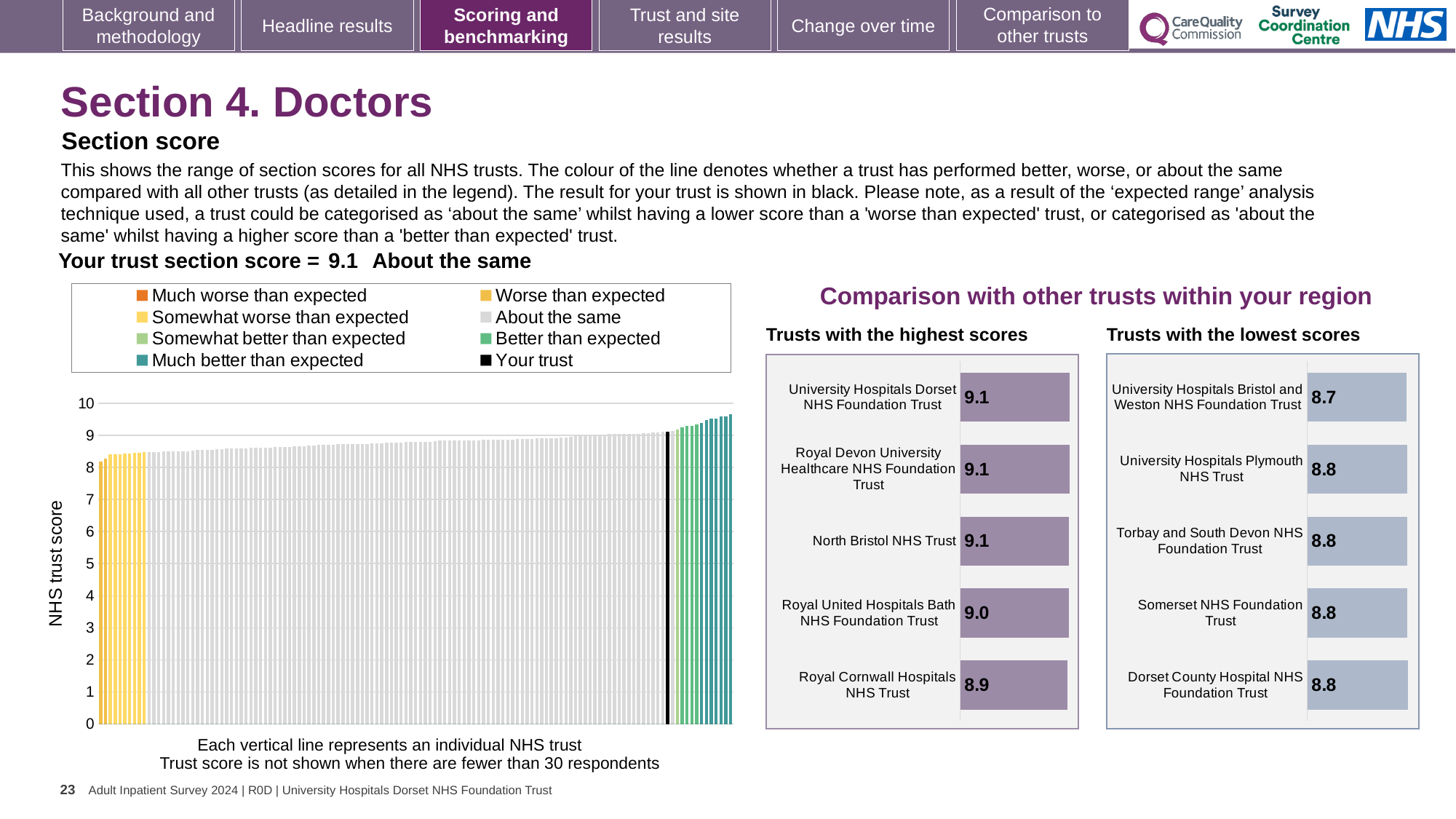
In the 'Trusts with the lowest scores' chart, what is the score for University Hospitals Bristol and Weston NHS Foundation Trust? 8.7 How many entries does the legend above the large chart on the left list? 8 What kind of chart is the large chart on the left showing NHS trust scores? bar chart In the 'Trusts with the highest scores' chart, how many trusts are listed? 5 In the 'Trusts with the lowest scores' chart, which trust has the lowest score? University Hospitals Bristol and Weston NHS Foundation Trust In the large chart on the left, do the trust scores rise or fall from left to right along the x axis? rise In the 'Trusts with the highest scores' chart, what is the score for University Hospitals Dorset NHS Foundation Trust? 9.1 In the large chart on the left, is the value of the leftmost bar greater or less than 8? greater In the 'Trusts with the highest scores' chart, which trust has the lowest score? Royal Cornwall Hospitals NHS Trust In the 'Trusts with the highest scores' chart, which has the larger score: Royal United Hospitals Bath NHS Foundation Trust or Royal Cornwall Hospitals NHS Trust? Royal United Hospitals Bath NHS Foundation Trust In the large chart on the left, what is the label on the vertical axis? NHS trust score In the 'Trusts with the highest scores' chart, what is the difference between the scores of University Hospitals Dorset NHS Foundation Trust and Royal Cornwall Hospitals NHS Trust? 0.2